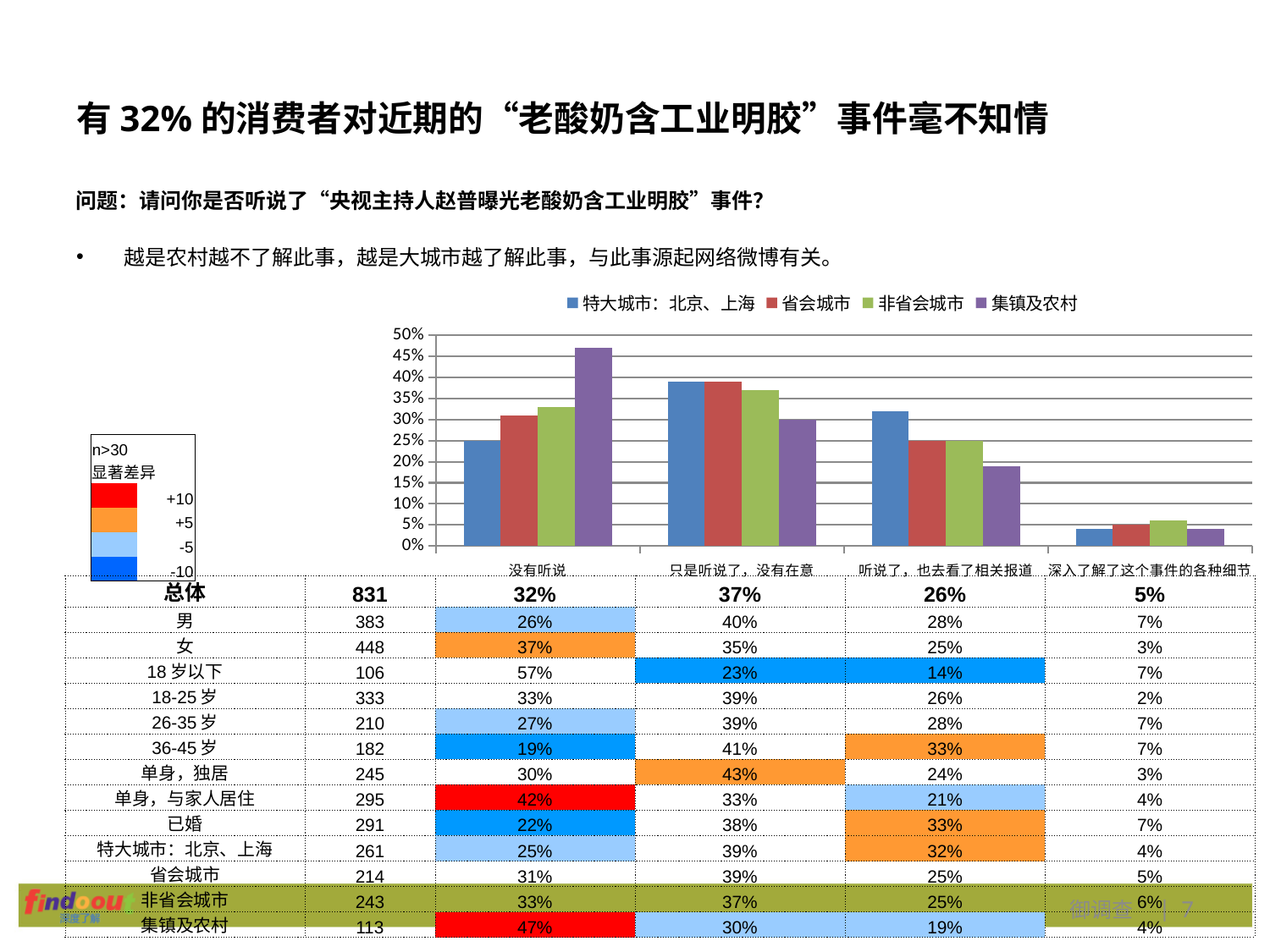
How many series does the chart legend list? 4 What kind of chart is shown on the slide? bar chart Is the value for 集镇及农村 in the 没有听说 category greater or less than 45%? greater Is the value for 特大城市：北京、上海 in the 只是听说了，没有在意 category greater or less than 35%? greater How many categories are shown along the x axis of the chart? 4 Which series has the lowest bar in the 没有听说 category? 特大城市：北京、上海 For the 集镇及农村 series, is the bar for 没有听说 larger or smaller than the bar for 只是听说了，没有在意? larger Which series has the highest bar in the 听说了，也去看了相关报道 category? 特大城市：北京、上海 Is the value for 集镇及农村 in the 听说了，也去看了相关报道 category greater or less than 20%? less Do the values for the 集镇及农村 series rise or fall from left to right across the x axis? fall Which series has the highest bar in the 没有听说 category? 集镇及农村